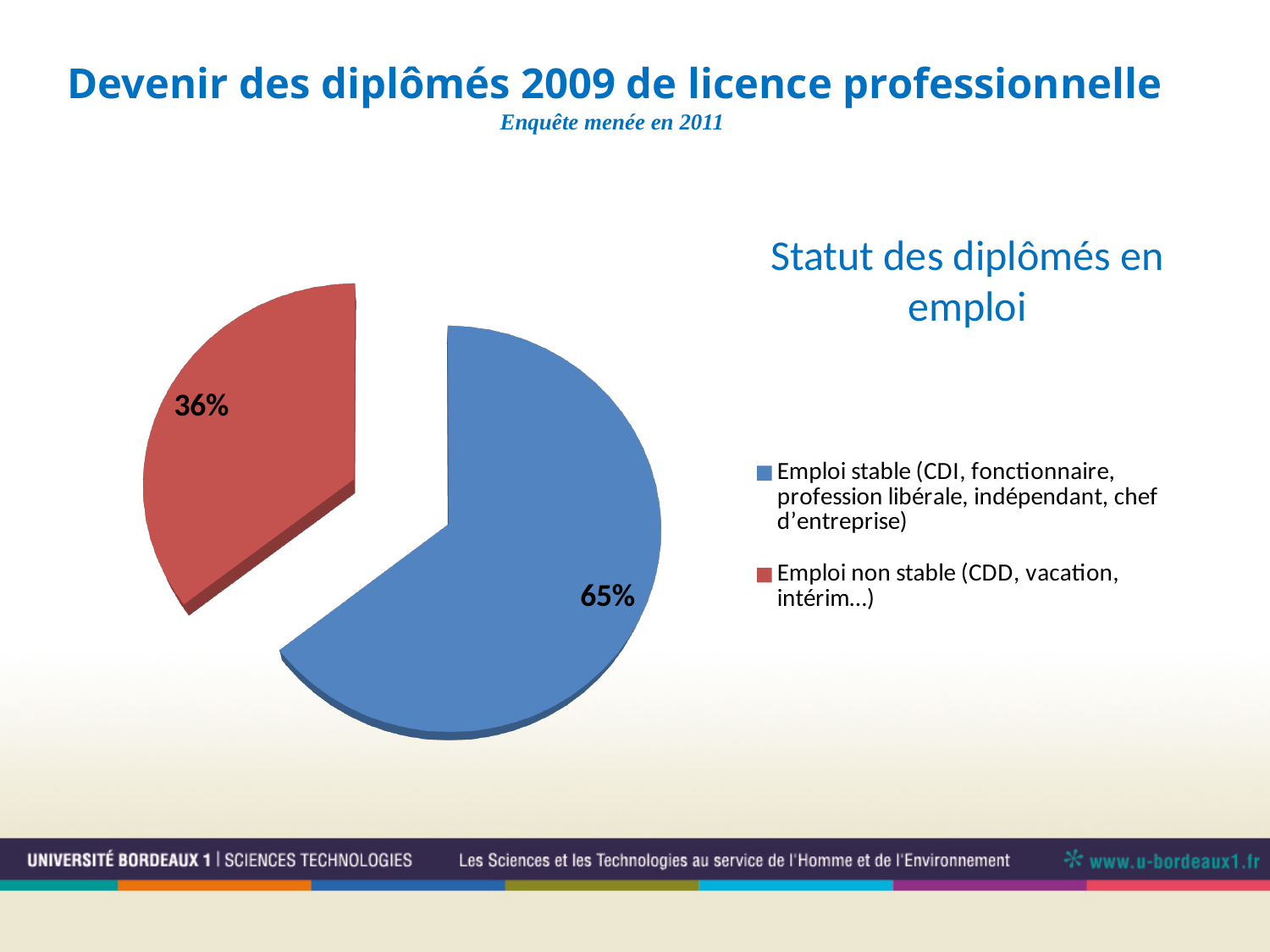
How many entries does the legend list? 2 How many slices does the pie chart have? 2 What is the difference in percentage points between the 'Emploi stable' slice and the 'Emploi non stable' slice? 29 percentage points What colour is the slice for 'Emploi non stable (CDD, vacation, intérim…)'? Red Is the share for 'Emploi stable' greater or less than 50%? greater What percentage of graduates are in 'Emploi non stable (CDD, vacation, intérim…)'? 36% What kind of chart is shown on the slide? Pie chart Which is larger: the share for 'Emploi stable' or the share for 'Emploi non stable'? Emploi stable Which category has the largest share of the pie? Emploi stable (CDI, fonctionnaire, profession libérale, indépendant, chef d'entreprise) Which category has the smallest share of the pie? Emploi non stable (CDD, vacation, intérim…) What is the title of the chart? Statut des diplômés en emploi What percentage of graduates are in 'Emploi stable (CDI, fonctionnaire, profession libérale, indépendant, chef d'entreprise)'? 65%